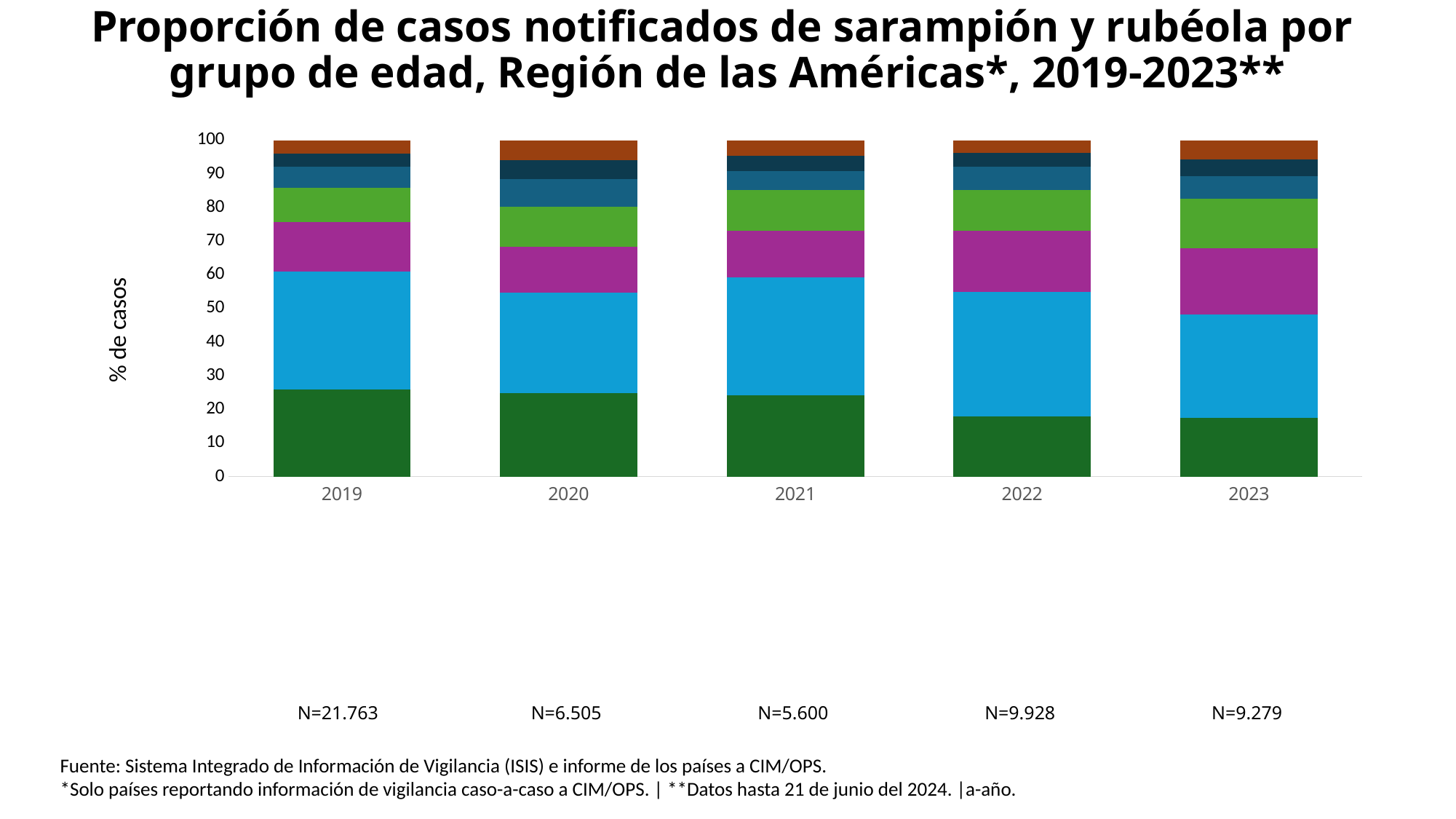
Does the bottom dark green segment rise or fall from 2019 to 2023? fall What is the N value printed for 2019? N=21.763 Which bar has the larger bottom dark green segment, 2019 or 2023? 2019 Is the bottom dark green segment of the 2023 bar greater or less than 20%? less Which year has the lowest N value? 2021 What kind of chart is shown on the slide? Stacked bar chart Which year has the highest N value? 2019 What is the N value printed for 2021? N=5.600 How many years (categories) are shown on the x axis? 5 What is the difference between the N values for 2019 and 2020? 15.258 What is the label on the y axis? % de casos Is the bottom dark green segment of the 2019 bar greater or less than 20%? greater